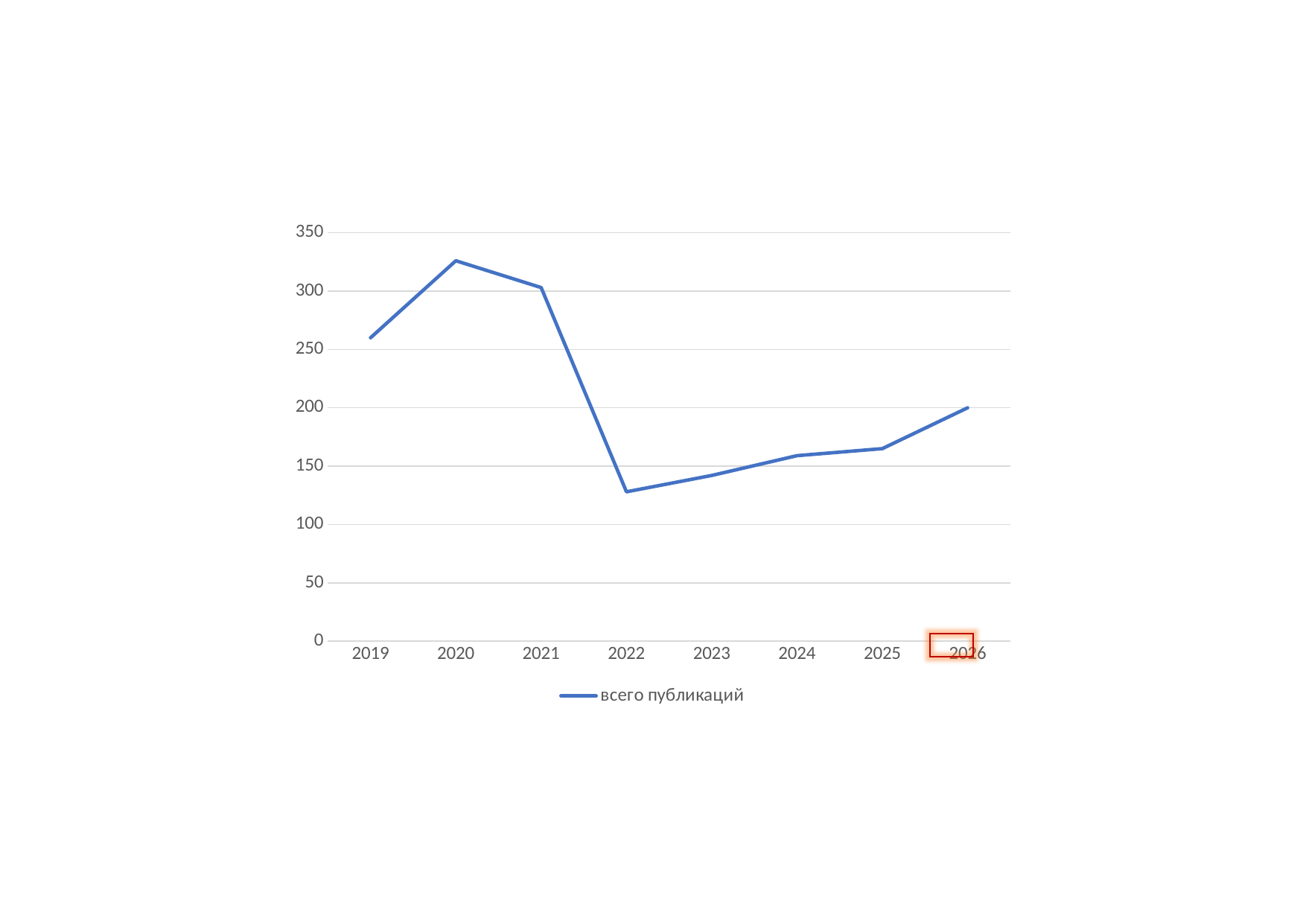
In which year is the value for всего публикаций lowest? 2022 Is the value for 2020 greater or less than 300? greater Is the value for 2022 greater or less than 150? less Does the value rise or fall from 2022 to 2026? rise What kind of chart is shown on the slide? line chart In which year is the value for всего публикаций highest? 2020 What is the name of the series shown in the legend? всего публикаций Does the value rise or fall from 2021 to 2022? fall How many years are plotted along the x axis? 8 Which year has the larger value, 2019 or 2023? 2019 Is the value for 2019 greater or less than 250? greater How many series does the legend list? 1